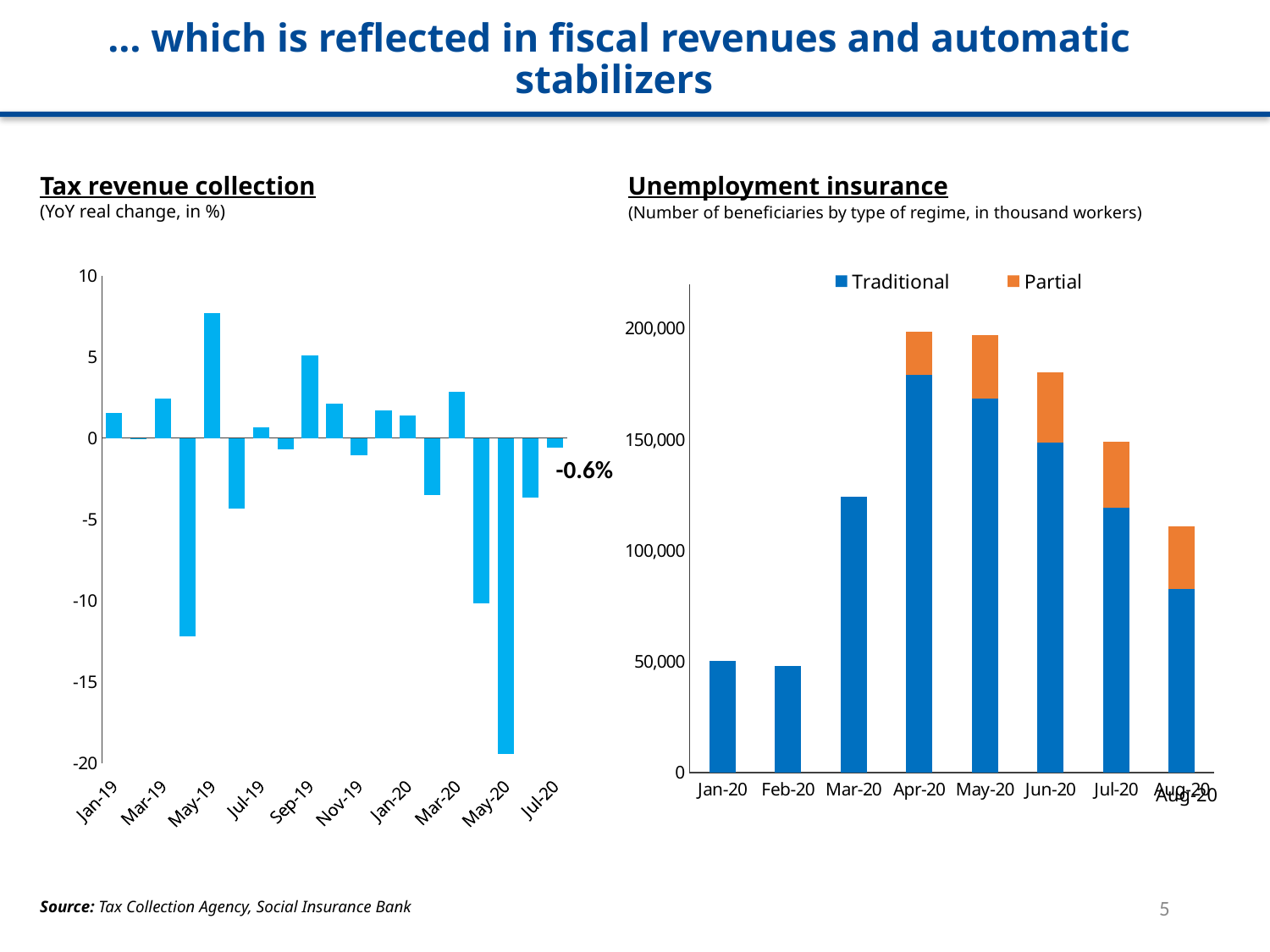
In the Tax revenue collection chart, which month has the lowest value? May-20 How many series does the legend of the Unemployment insurance chart list? 2 In the Tax revenue collection chart, which month has the highest value? May-19 In the Unemployment insurance chart, is the total for Jan-20 greater or less than 100,000? less What kind of chart is the Tax revenue collection chart? Bar chart In the Unemployment insurance chart, is the total for Mar-20 greater or less than 100,000? greater In the Tax revenue collection chart, is the value for May-20 greater or less than -15? less In the Unemployment insurance chart, which colour represents the Partial regime? Orange In the Tax revenue collection chart, what is the YoY real change for Jul-20? -0.6% How many months are shown on the x axis of the Unemployment insurance chart? 8 In the Unemployment insurance chart, which has a larger total, Jan-20 or Apr-20? Apr-20